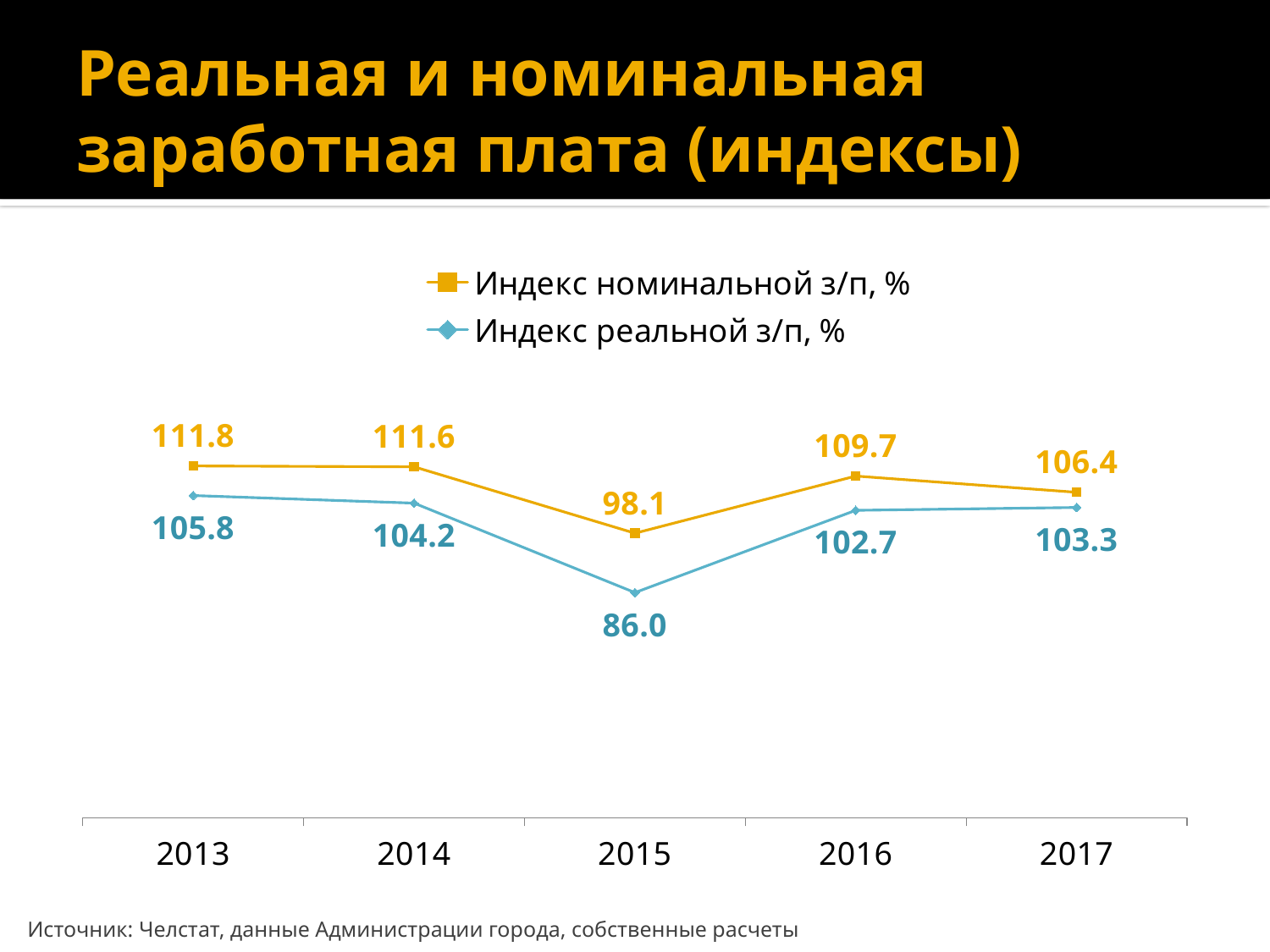
In which year is Индекс реальной з/п, % lowest? 2015 What is the difference between Индекс реальной з/п, % in 2016 and in 2015? 16.7 Does Индекс номинальной з/п, % rise or fall from 2016 to 2017? fall What is the value of Индекс реальной з/п, % for 2017? 103.3 In which year is Индекс номинальной з/п, % highest? 2013 What kind of chart is shown on the slide? line chart What is the value of Индекс номинальной з/п, % for 2015? 98.1 What is the value of Индекс реальной з/п, % for 2013? 105.8 Which is larger: Индекс реальной з/п, % in 2016 or in 2017? 2017 How many years are shown on the x axis? 5 How many series does the legend list? 2 What is the difference between Индекс номинальной з/п, % and Индекс реальной з/п, % in 2015? 12.1